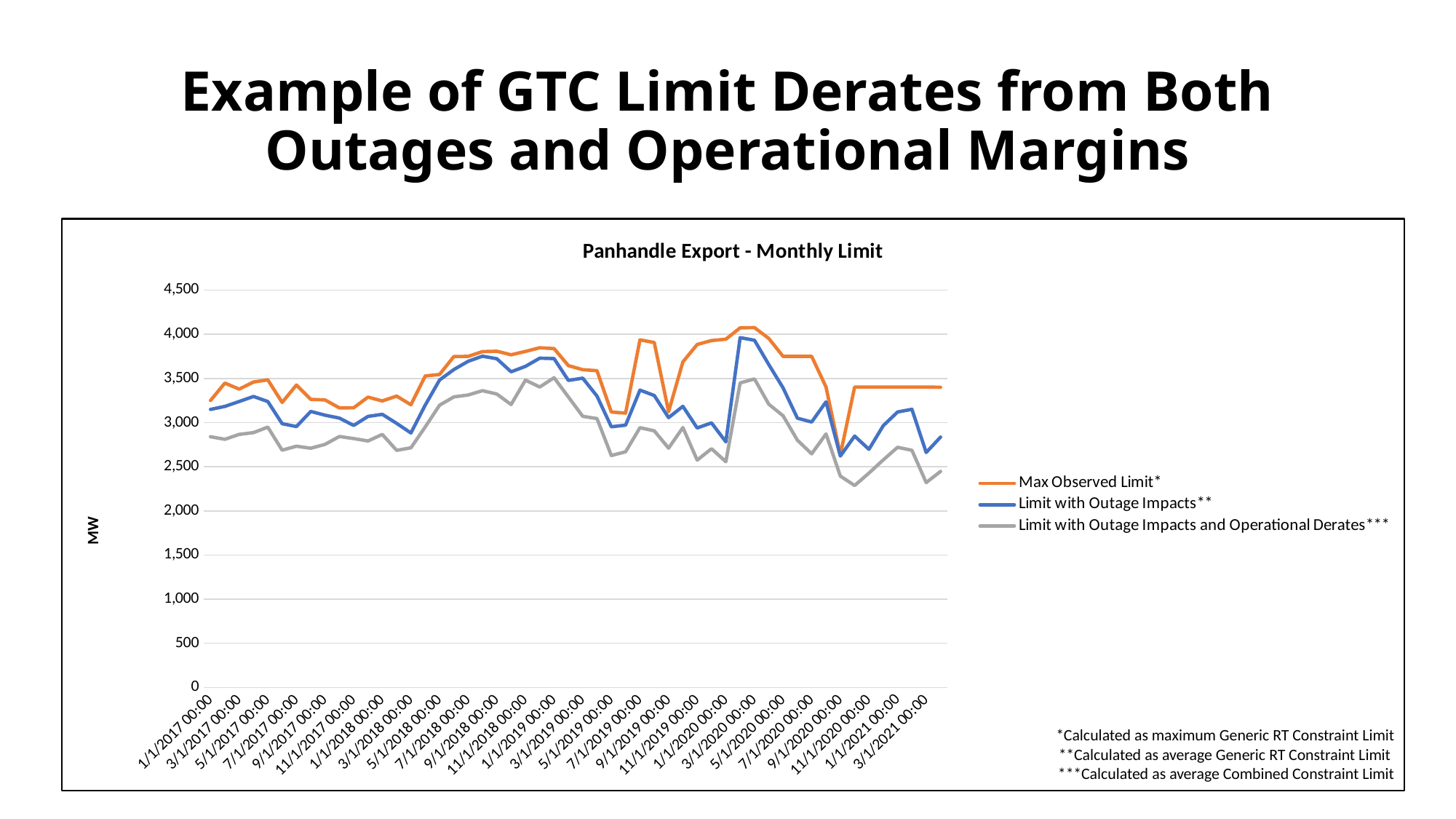
Is the Limit with Outage Impacts and Operational Derates value at 1/1/2017 00:00 greater or less than 3,000? less Does the Max Observed Limit rise or fall between 3/1/2020 00:00 and 11/1/2020 00:00? Fall At 1/1/2017 00:00, which is larger: the Max Observed Limit or the Limit with Outage Impacts and Operational Derates? Max Observed Limit How many series does the legend list in the Panhandle Export - Monthly Limit chart? 3 Is the Max Observed Limit value at 3/1/2020 00:00 greater or less than 4,000? greater What is the label on the vertical axis of the chart? MW Which series generally has the lowest values across the chart? Limit with Outage Impacts and Operational Derates Which series generally has the highest values across the chart? Max Observed Limit What type of chart is shown on the slide? Line chart Is the Limit with Outage Impacts and Operational Derates value at 11/1/2020 00:00 greater or less than 2,500? less What is the title of the chart? Panhandle Export - Monthly Limit